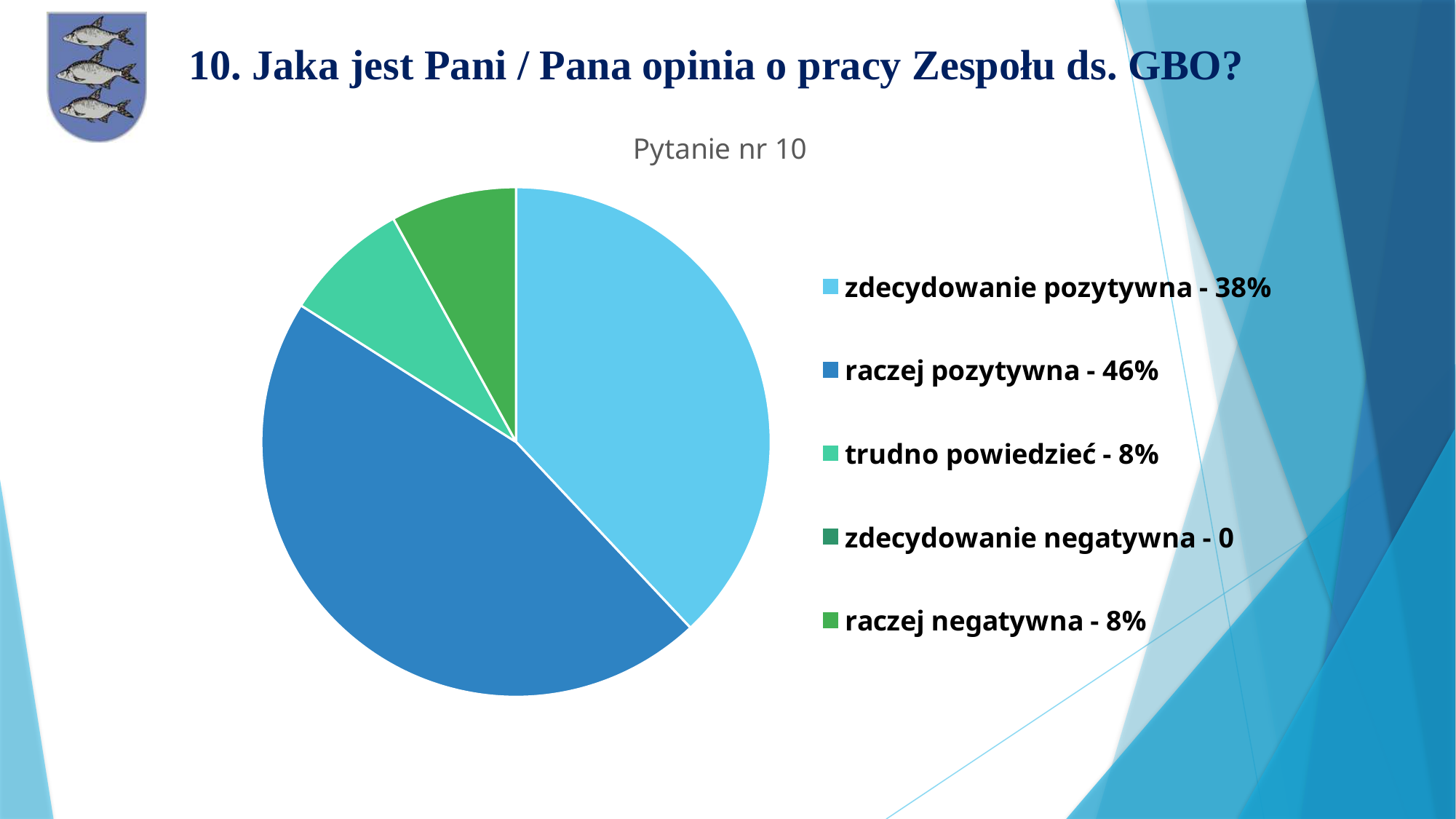
Which category has the smallest value in the legend? zdecydowanie negatywna What is the combined share of 'zdecydowanie pozytywna' and 'raczej pozytywna'? 84% What is the difference between the shares for 'raczej pozytywna' and 'zdecydowanie pozytywna'? 8% What share of responses is 'raczej pozytywna'? 46% What share of responses is 'zdecydowanie pozytywna'? 38% Which category has the largest share of the pie? raczej pozytywna How many categories does the legend list? 5 What type of chart is shown on the slide? pie chart What share of responses is 'trudno powiedzieć'? 8% What value is shown for 'zdecydowanie negatywna'? 0 What is the title of the chart? Pytanie nr 10 Which is larger: the share for 'zdecydowanie pozytywna' or for 'raczej negatywna'? zdecydowanie pozytywna